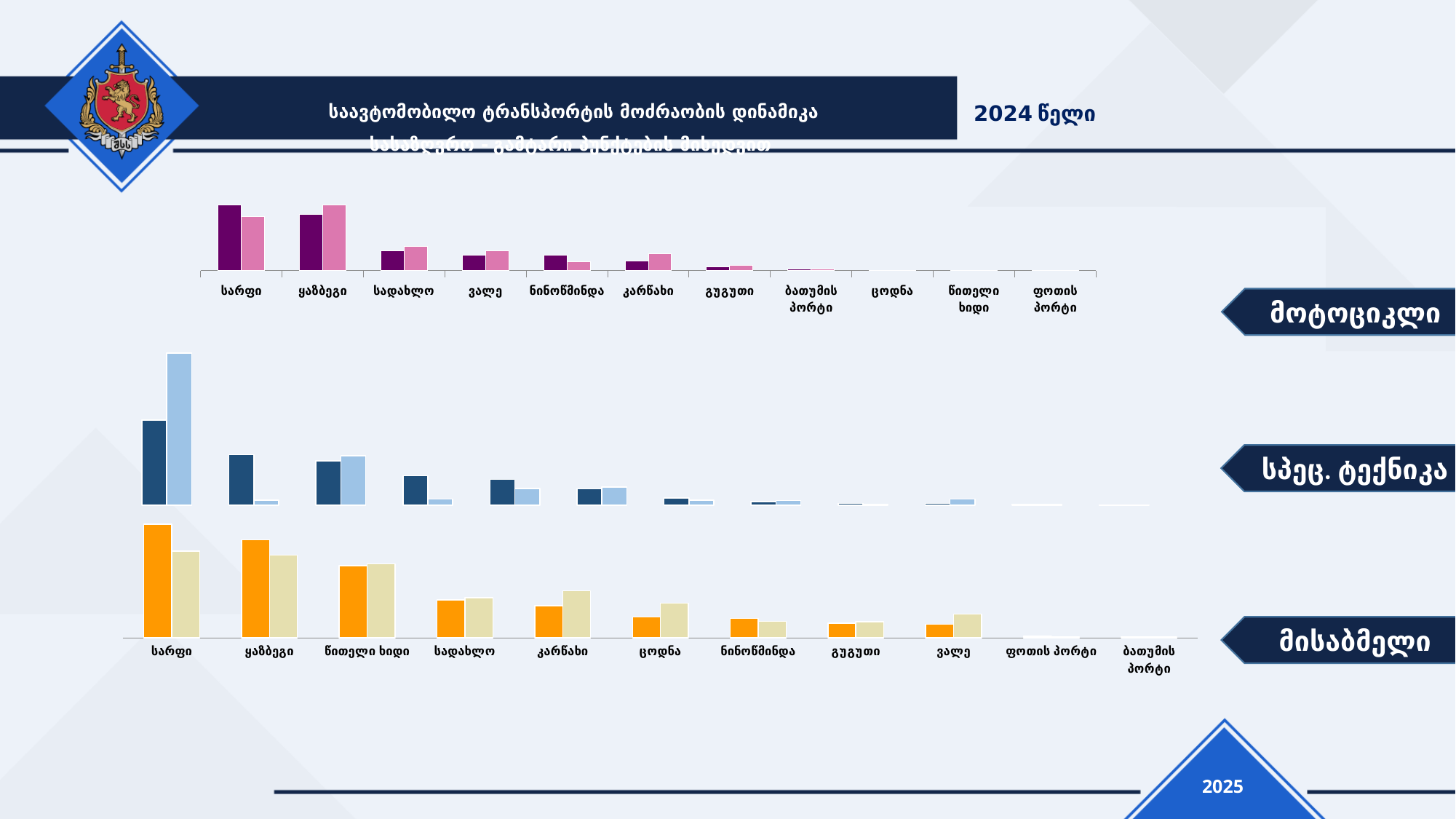
How many categories are shown on the x axis of the chart labelled მისაბმელი? 11 What kind of chart is the chart labelled მისაბმელი at the bottom of the slide? bar chart In the chart labelled მოტოციკლი, is the dark purple bar larger for სარფი or for სადახლო? სარფი In the chart labelled მოტოციკლი, which category has the tallest pink bar? ყაზბეგი How many bar colours (series) are plotted in the chart labelled სპეც. ტექნიკა? 2 In the chart labelled მისაბმელი, is the orange bar larger for ყაზბეგი or for წითელი ხიდი? ყაზბეგი In the chart labelled მისაბმელი, is the beige bar larger for კარწახი or for ცოდნა? კარწახი In the chart labelled მისაბმელი, do the orange bars generally rise or fall from left to right along the x axis? fall In the chart labelled მისაბმელი, which category has the tallest orange bar? სარფი How many categories are shown on the x axis of the chart labelled მოტოციკლი? 11 What kind of chart is the chart labelled მოტოციკლი at the top of the slide? bar chart What year is shown in the header next to the slide title? 2024 წელი